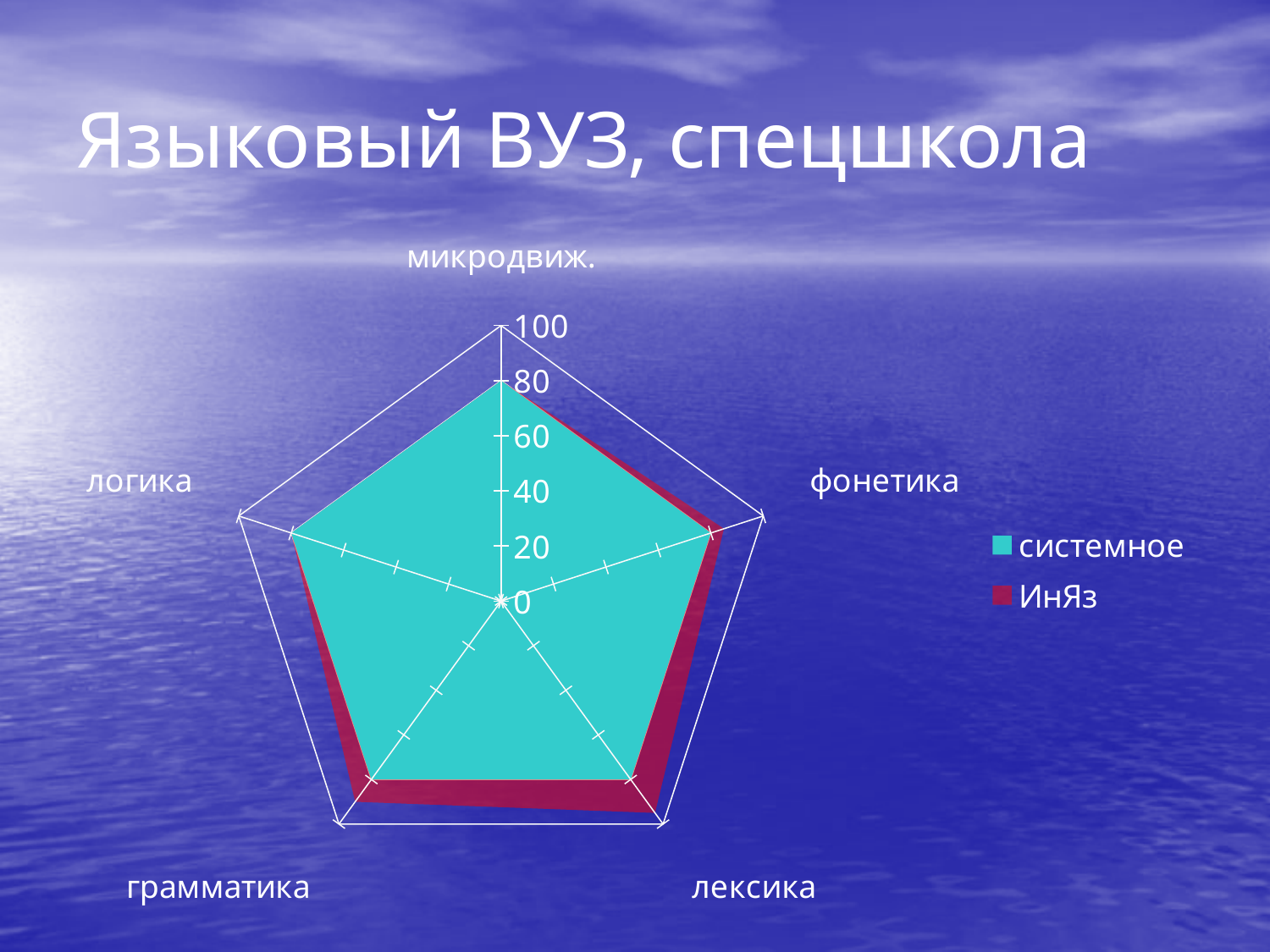
What are the two series named in the legend? системное, ИнЯз Is the value of ИнЯз for микродвиж. greater or less than 100? less For лексика, which series has the larger value, системное or ИнЯз? ИнЯз What kind of chart is shown on the slide? radar chart Is the value of системное for логика greater or less than 60? greater How many series does the legend list? 2 What is the maximum value shown on the radar chart's axis scale? 100 Is the value of ИнЯз for лексика greater or less than 60? greater What is the title of the slide containing the chart? Языковый ВУЗ, спецшкола What is the value of the системное series for микродвиж.? 80 How many categories (axes) does the radar chart have? 5